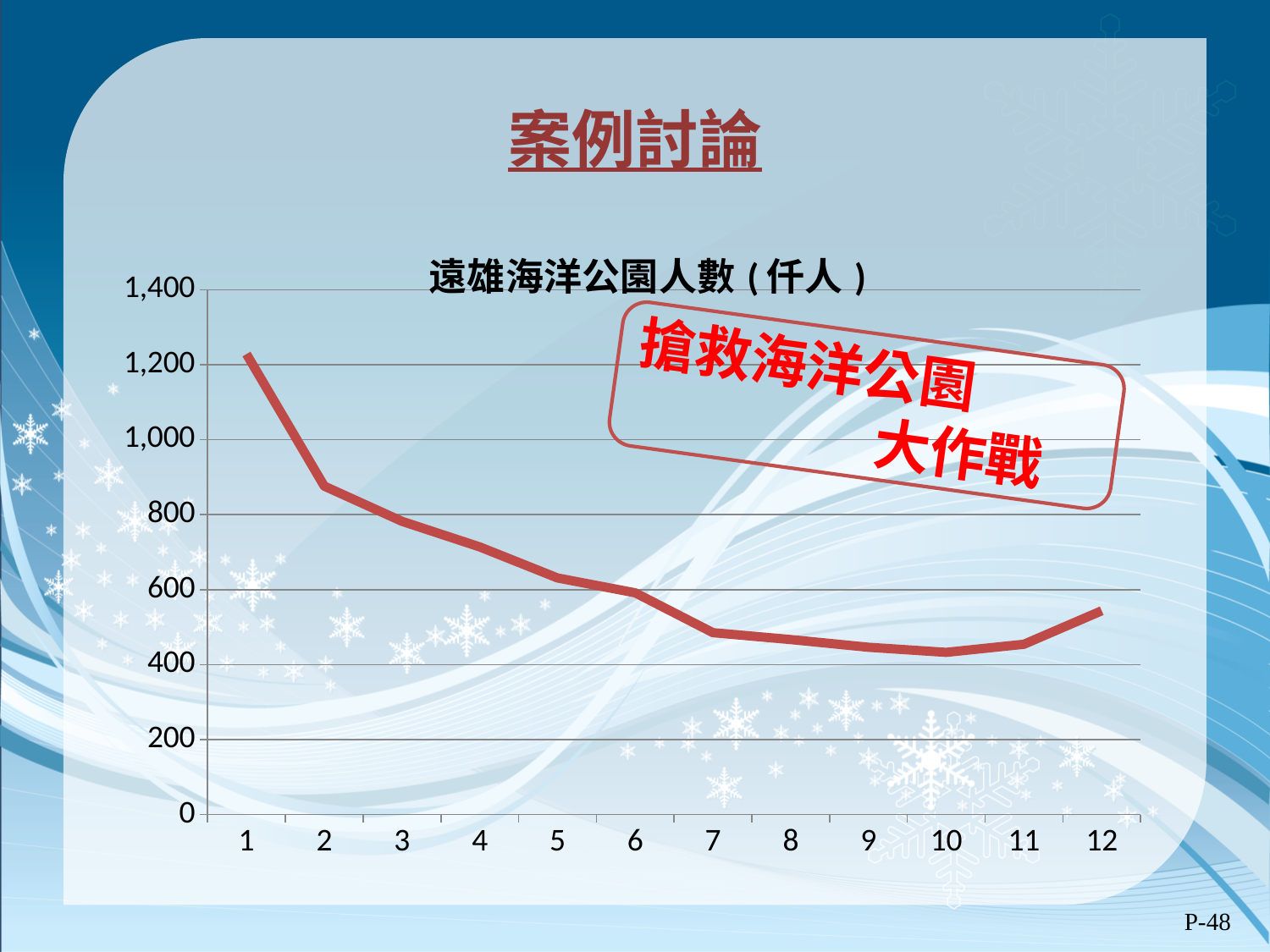
Is the value at x = 2 greater or less than 800? greater What kind of chart is shown on the slide? line chart How many points are plotted along the x axis of the chart? 12 At which x-axis value is the plotted value highest? 1 Which is larger, the value at x = 3 or the value at x = 9? x = 3 Is the value at x = 7 greater or less than 600? less Is the value at x = 1 greater or less than 1,200? greater At which x-axis value is the plotted value lowest? 10 What is the highest value shown on the y axis of the chart? 1,400 Do the values generally rise or fall from x = 1 to x = 10? fall What is the title of the chart? 遠雄海洋公園人數 ( 仟人 )